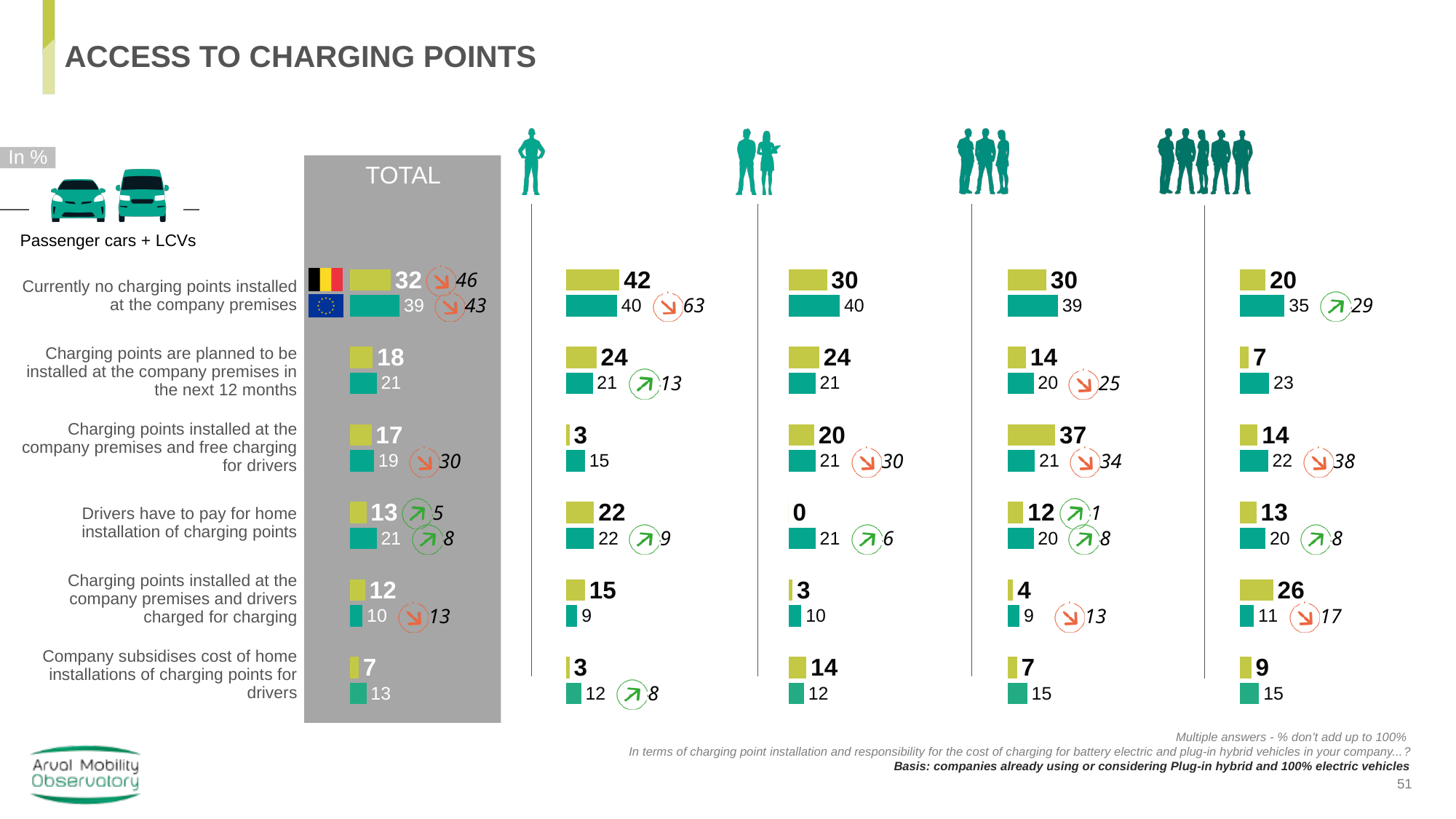
In the TOTAL column, what is the EU (teal bar) value for 'Currently no charging points installed at the company premises'? 39 In the TOTAL column, which category has the lowest Belgium value? Company subsidises cost of home installations of charging points for drivers In the TOTAL column, what is the difference between the EU value and the Belgium value for 'Drivers have to pay for home installation of charging points'? 8 In the TOTAL column, what is the Belgium (yellow-green bar) value for 'Currently no charging points installed at the company premises'? 32 In the TOTAL column, for 'Charging points are planned to be installed at the company premises in the next 12 months', is the Belgium value or the EU value larger? EU What kind of chart is used on this slide? Bar chart In the TOTAL column, what is the Belgium value for 'Company subsidises cost of home installations of charging points for drivers'? 7 In the TOTAL column, which category has the highest Belgium value? Currently no charging points installed at the company premises In what unit are the values on the chart expressed? % In the first column to the right of TOTAL (single-person icon), what is the Belgium value for 'Currently no charging points installed at the company premises'? 42 How many answer categories (rows) are shown in the chart? 6 In the rightmost column (largest company icon), what is the Belgium value for 'Charging points installed at the company premises and drivers charged for charging'? 26